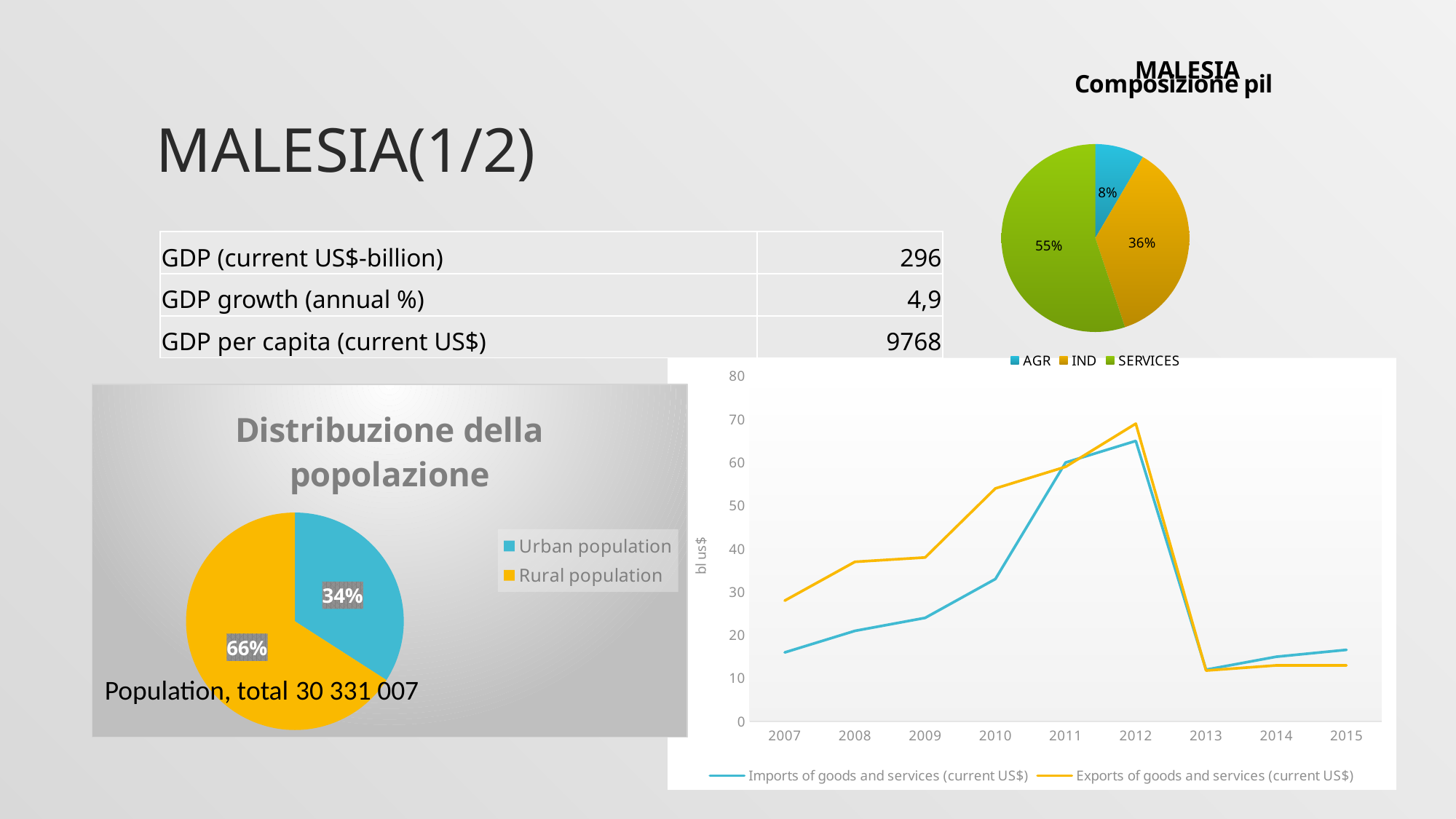
In the 'Distribuzione della popolazione' pie chart, what share is Rural population? 66% In the 'Distribuzione della popolazione' pie chart, which is larger, Urban population or Rural population? Rural population In the line chart at the bottom right, which series is higher in 2010, Imports or Exports of goods and services? Exports of goods and services (current US$) In the line chart at the bottom right, is the value for Exports of goods and services in 2012 greater or less than 60? greater In the 'Composizione pil' pie chart, what share does SERVICES have? 55% In the line chart at the bottom right, how many years are shown on the x axis? 9 In the 'Composizione pil' pie chart, what share does AGR have? 8% In the 'Composizione pil' pie chart, what is the difference between the IND share and the AGR share? 28% In the 'Composizione pil' pie chart, which sector has the smallest share? AGR What kind of chart is the chart at the bottom right showing imports and exports? Line chart In the 'Distribuzione della popolazione' pie chart, how many series does the legend list? 2 In the 'Composizione pil' pie chart, which sector has the largest share? SERVICES